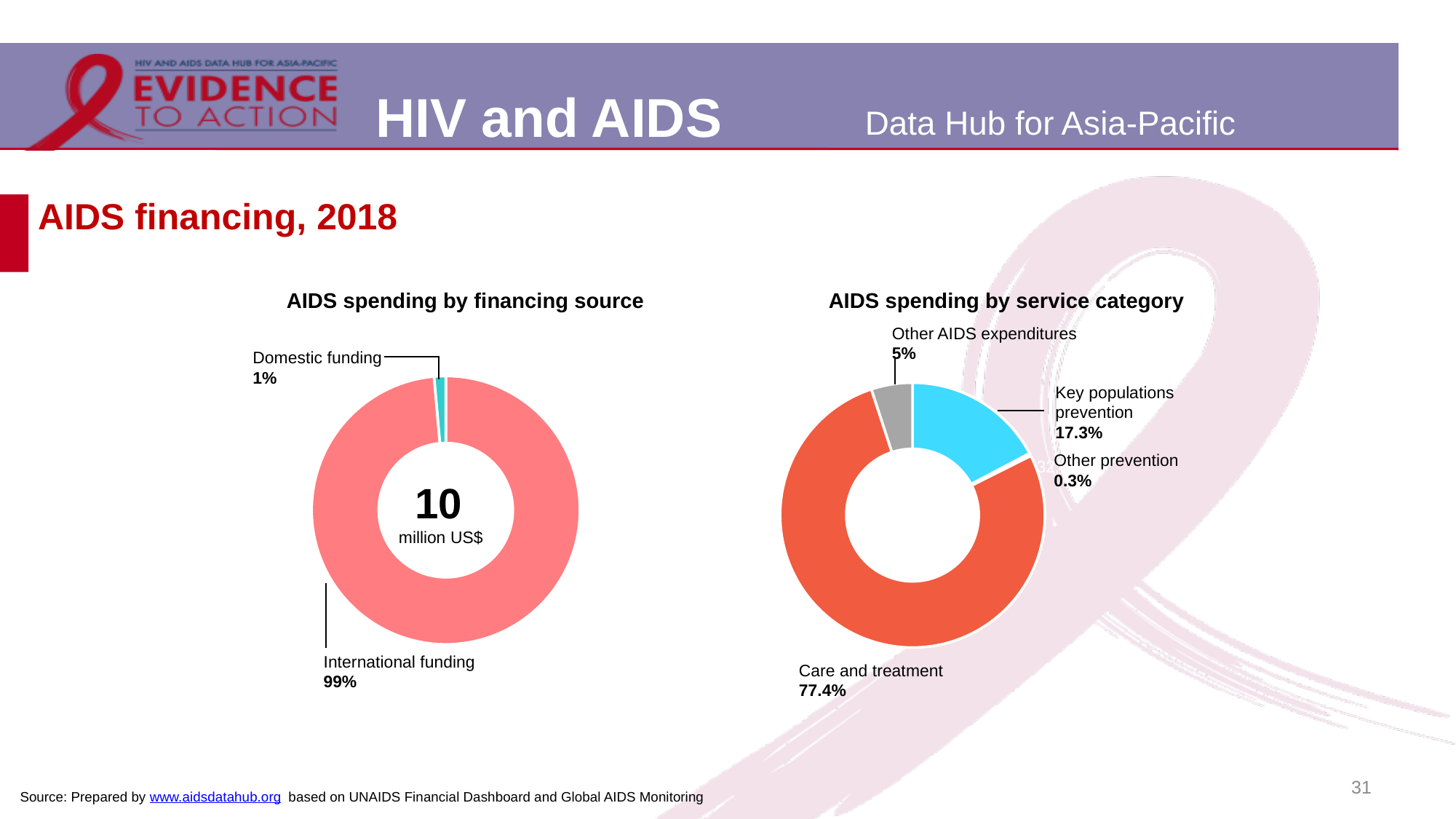
In the 'AIDS spending by financing source' chart, how many financing sources are shown? 2 In the 'AIDS spending by financing source' chart, what share of spending comes from international funding? 99% In the 'AIDS spending by service category' chart, what is the difference between the shares for care and treatment and key populations prevention? 60.1% In the 'AIDS spending by service category' chart, what share of spending goes to care and treatment? 77.4% In the 'AIDS spending by financing source' chart, what share of spending comes from domestic funding? 1% In the 'AIDS spending by financing source' chart, which financing source is the largest? International funding In the 'AIDS spending by service category' chart, how many service categories are shown? 4 In the 'AIDS spending by service category' chart, what share of spending goes to other prevention? 0.3% In the 'AIDS spending by financing source' chart, what total amount is shown in the centre of the donut? 10 million US$ What type of chart is used for 'AIDS spending by service category'? Donut (pie) chart In the 'AIDS spending by service category' chart, which service category has the smallest share? Other prevention In the 'AIDS spending by service category' chart, what share of spending goes to key populations prevention? 17.3%